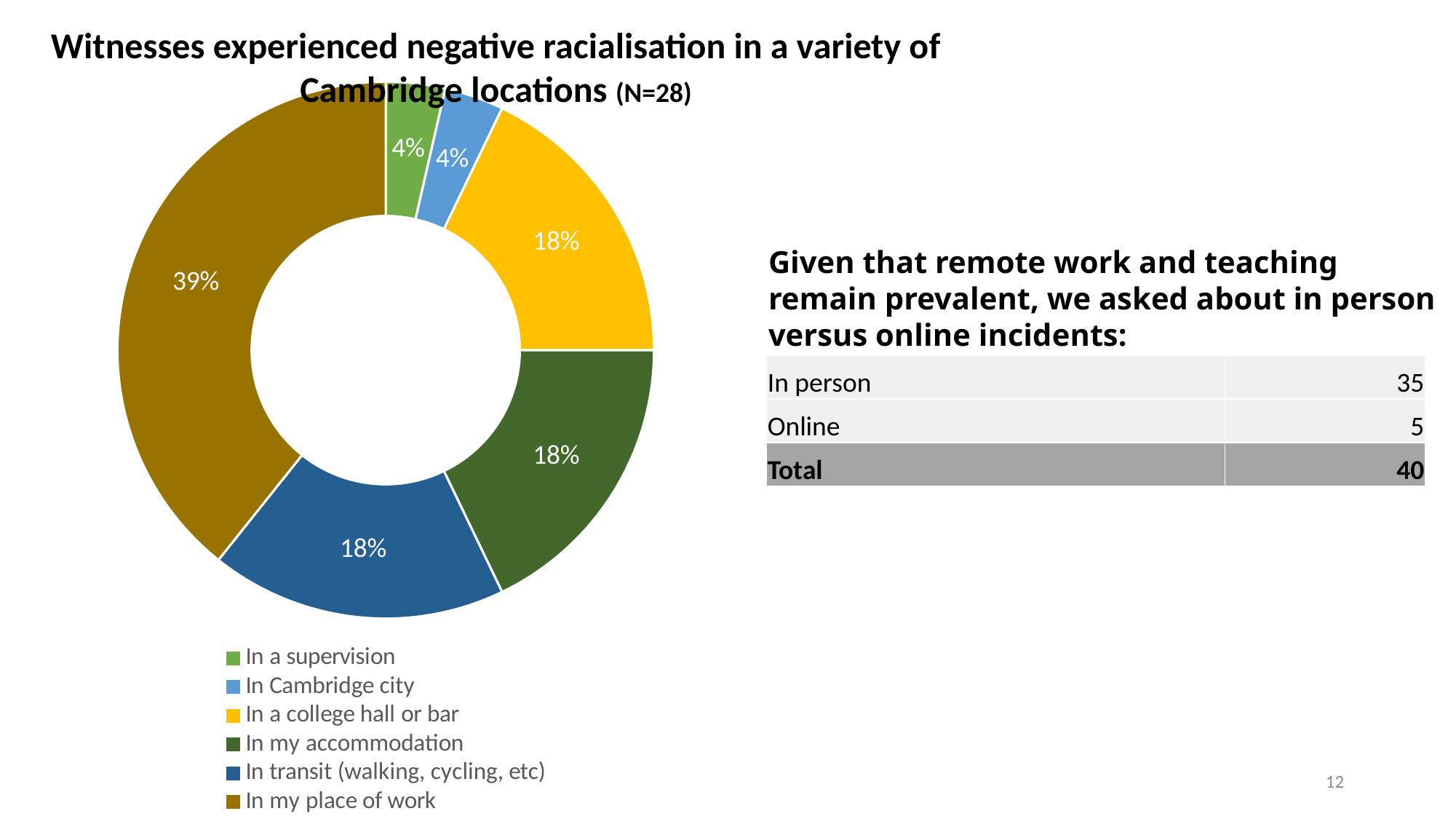
Which colour represents 'In a college hall or bar' in the chart? Yellow What percentage is shown for 'In a college hall or bar'? 18% What is the combined percentage for 'In a supervision' and 'In Cambridge city'? 8% What sample size (N) is stated in the chart title? N=28 What percentage of witnesses experienced negative racialisation in their place of work? 39% What percentage is shown for 'In transit (walking, cycling, etc)'? 18% What kind of chart is shown on the slide? Doughnut (pie) chart What is the difference in percentage points between 'In my place of work' and 'In my accommodation'? 21 Which is larger, the share for 'In Cambridge city' or the share for 'In my accommodation'? In my accommodation What percentage is shown for 'In a supervision'? 4% Which location has the largest share of the chart? In my place of work How many location categories does the legend list? 6